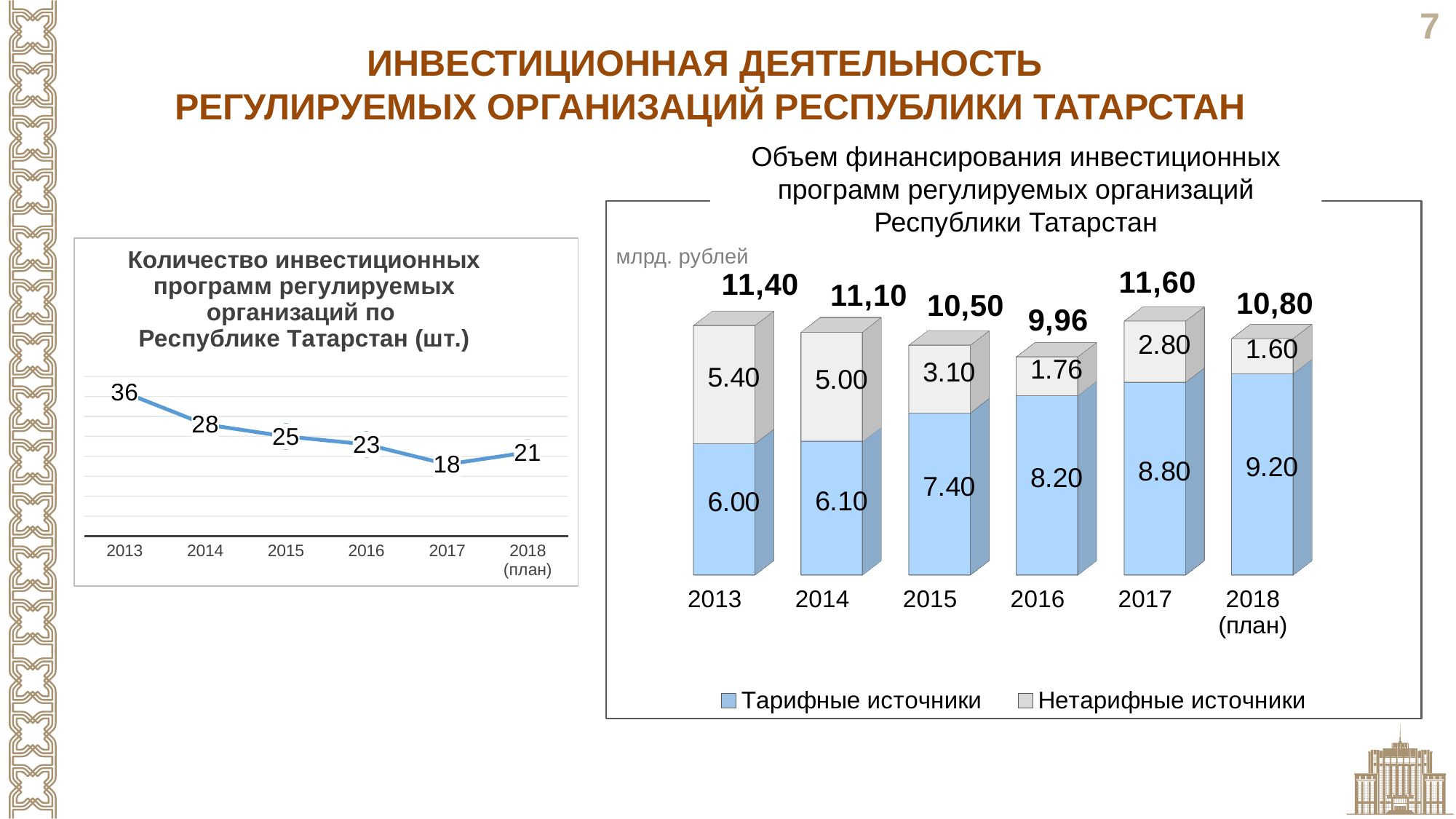
In the left chart (Количество инвестиционных программ), what is the value for 2013? 36 In the right chart (Объем финансирования), which is larger: Тарифные источники in 2013 or Нетарифные источники in 2013? Тарифные источники In the right chart (Объем финансирования), what is the total of the stacked bar for 2017? 11,60 In the left chart (Количество инвестиционных программ), what is the difference between the values for 2013 and 2017? 18 In the left chart (Количество инвестиционных программ), which year has the lowest value? 2017 How many series does the legend of the right chart (Объем финансирования) list? 2 What kind of chart is the left chart (Количество инвестиционных программ)? line chart In the left chart (Количество инвестиционных программ), do the values generally rise or fall from 2013 to 2017? fall In the right chart (Объем финансирования), what is the value of Тарифные источники for 2016? 8.20 What kind of chart is the right chart (Объем финансирования)? stacked bar chart In the right chart (Объем финансирования), which year has the highest total? 2017 In the right chart (Объем финансирования), what is the value of Нетарифные источники for 2014? 5.00